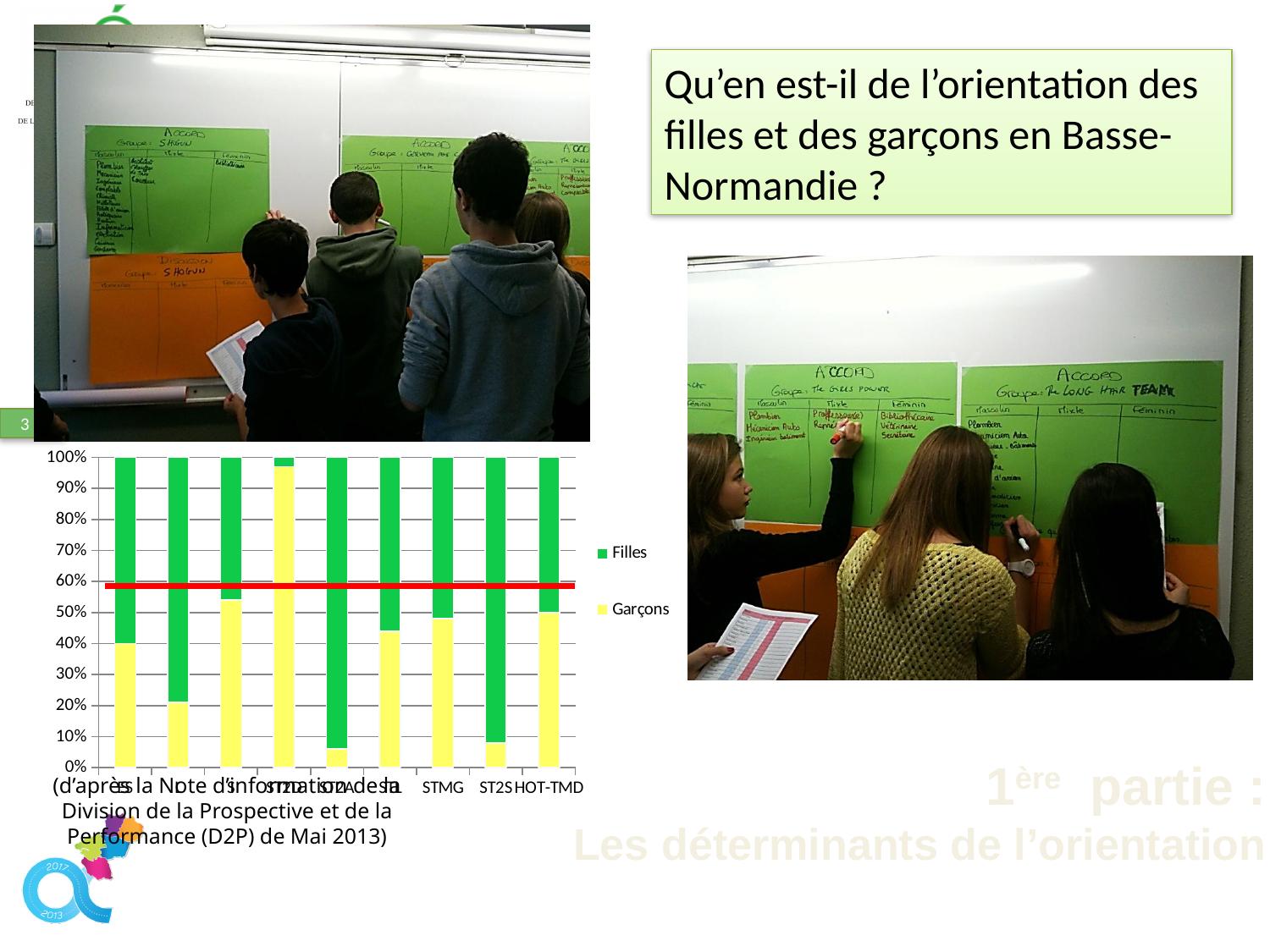
Which colour represents Garçons in the bar chart? Yellow Is the Garçons share for HOT-TMD greater or less than 40%? greater Which has the larger Garçons share, STMG or ST2S? STMG Among STMG, ST2S and HOT-TMD, which has the lowest Garçons share? ST2S What kind of chart is shown at the bottom left of the slide? Stacked bar chart How many series does the legend of the bar chart list? 2 How many bars are plotted in the bar chart? 9 What are the two series named in the legend of the bar chart? Filles and Garçons Among STMG, ST2S and HOT-TMD, which has the highest Filles share? ST2S